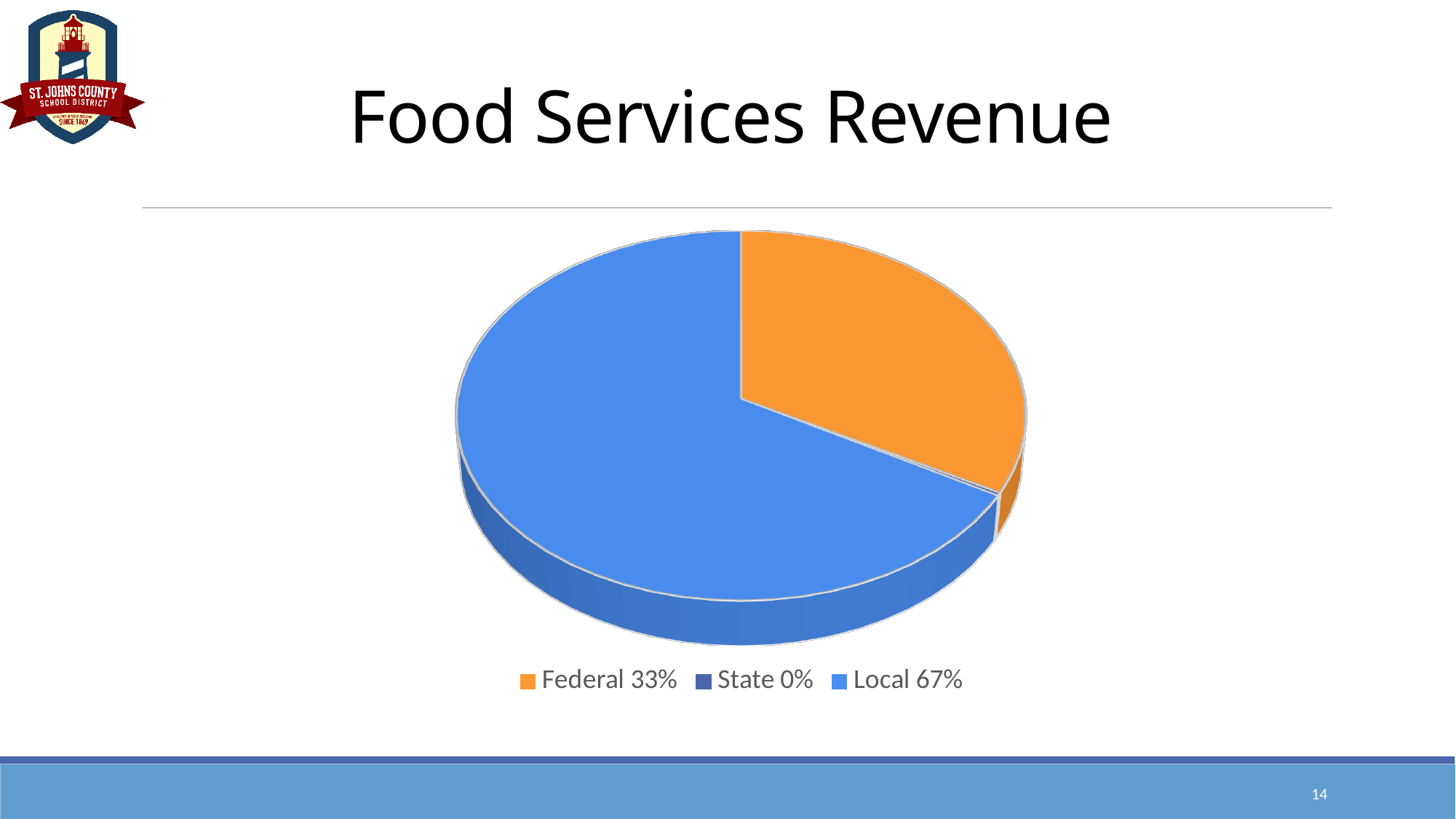
What is the title of the chart? Food Services Revenue What share of Food Services Revenue comes from Local sources? 67% What kind of chart is shown on the slide? Pie chart What colour represents the Federal slice? Orange Which revenue source has the smallest share of Food Services Revenue? State How many revenue sources are listed in the legend? 3 What is the difference in percentage points between the Local and Federal shares? 34 What share of Food Services Revenue comes from State sources? 0% Which is larger, the Federal share or the Local share? Local What share of Food Services Revenue comes from Federal sources? 33% Which revenue source has the largest share of Food Services Revenue? Local